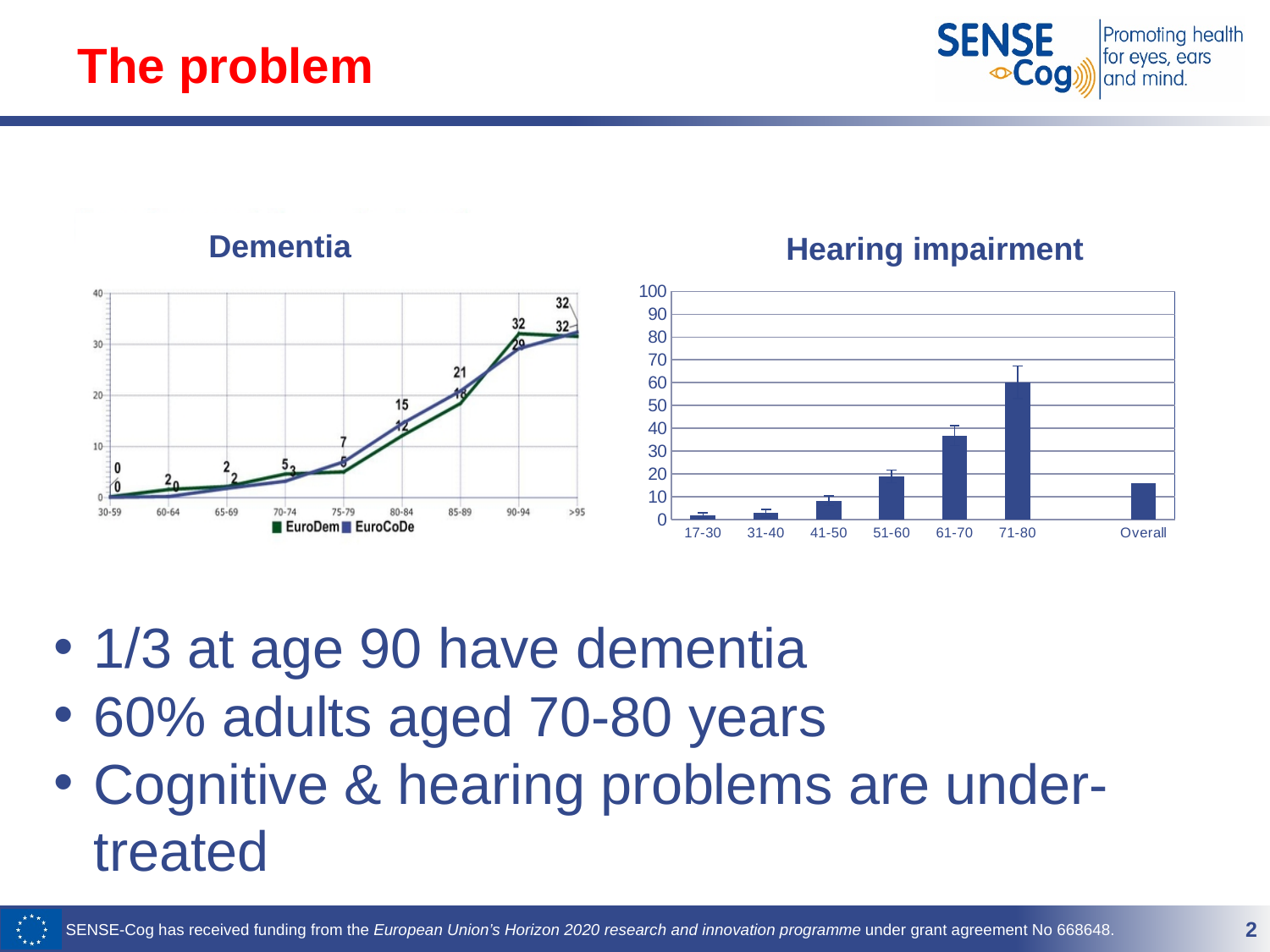
What kind of chart is the Dementia chart? line chart In the Hearing impairment chart, is the value for 71-80 greater or less than 50? greater How many series does the legend of the Dementia chart list? 2 In the Hearing impairment chart, which is larger, the value for 61-70 or the value for 51-60? 61-70 In the Dementia chart, do the values rise or fall as age increases along the x axis? rise In the Dementia chart, what value is labelled for both series at the >95 age group? 32 How many categories are shown on the x axis of the Hearing impairment chart? 7 In the Hearing impairment chart, which age group has the highest bar? 71-80 What kind of chart is the Hearing impairment chart? bar chart In the Hearing impairment chart, which age group has the lowest bar? 17-30 How many age categories are shown on the x axis of the Dementia chart? 9 In the Hearing impairment chart, is the value for Overall greater or less than 20? less